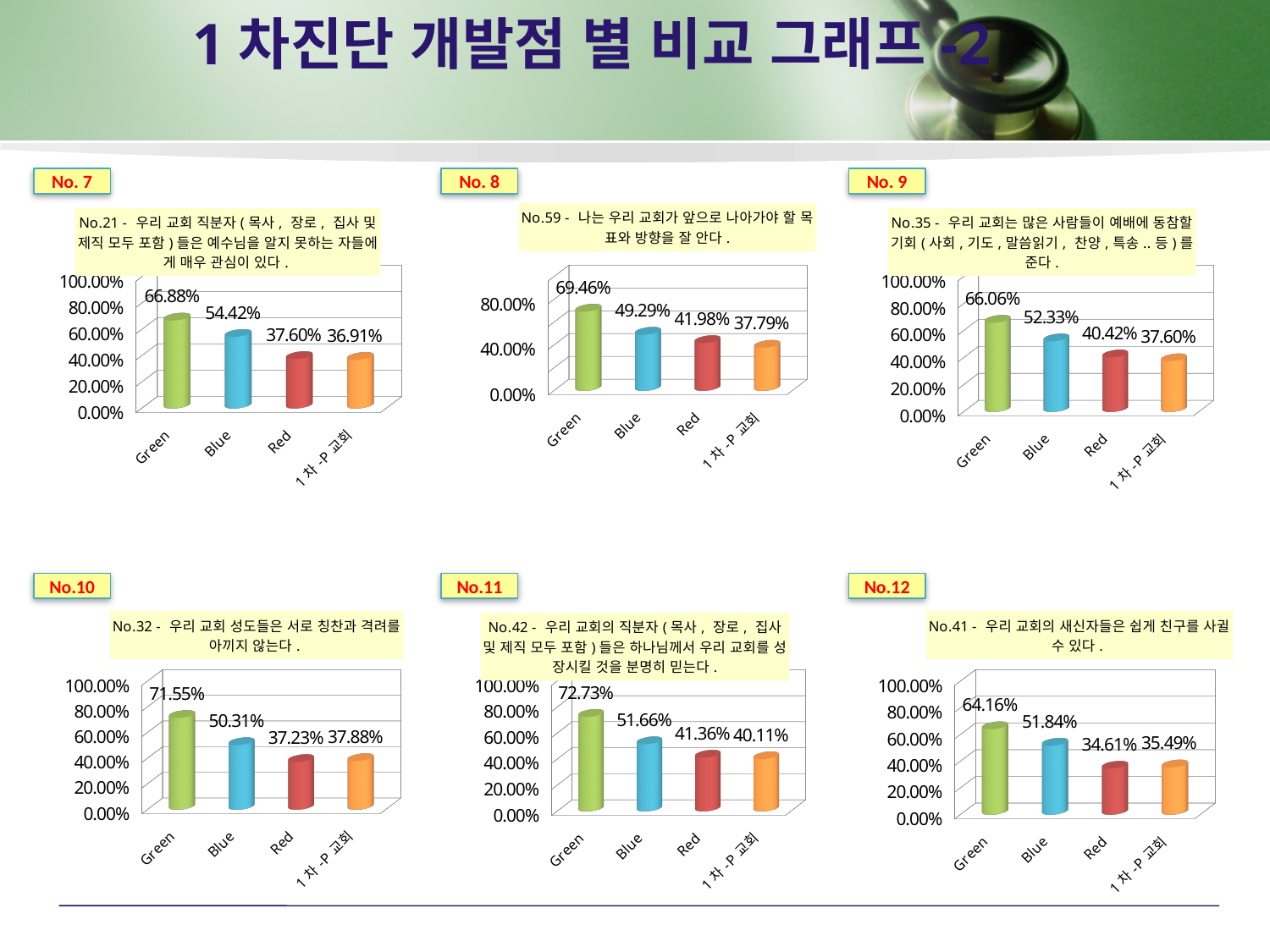
In the No. 7 chart, what is the value for Green? 66.88% In the No. 8 chart, what is the value for Blue? 49.29% In the No.10 chart, which category has the highest value? Green In the No.10 chart, which is larger, the value for Red or the value for 1차-P 교회? 1차-P 교회 In the No.12 chart, which category has the lowest value? Red In the No. 8 chart, is the value for Green greater or less than 40.00%? greater In the No.11 chart, what is the difference between the Green value and the Blue value? 21.07% In the No. 9 chart, what is the value for 1차-P 교회? 37.60% How many categories are shown on the x axis of the No. 9 chart? 4 What kind of chart is the No.11 chart? Bar chart How many charts are shown on the slide? 6 In the No. 7 chart, do the values rise or fall from Green to 1차-P 교회 along the x axis? Fall